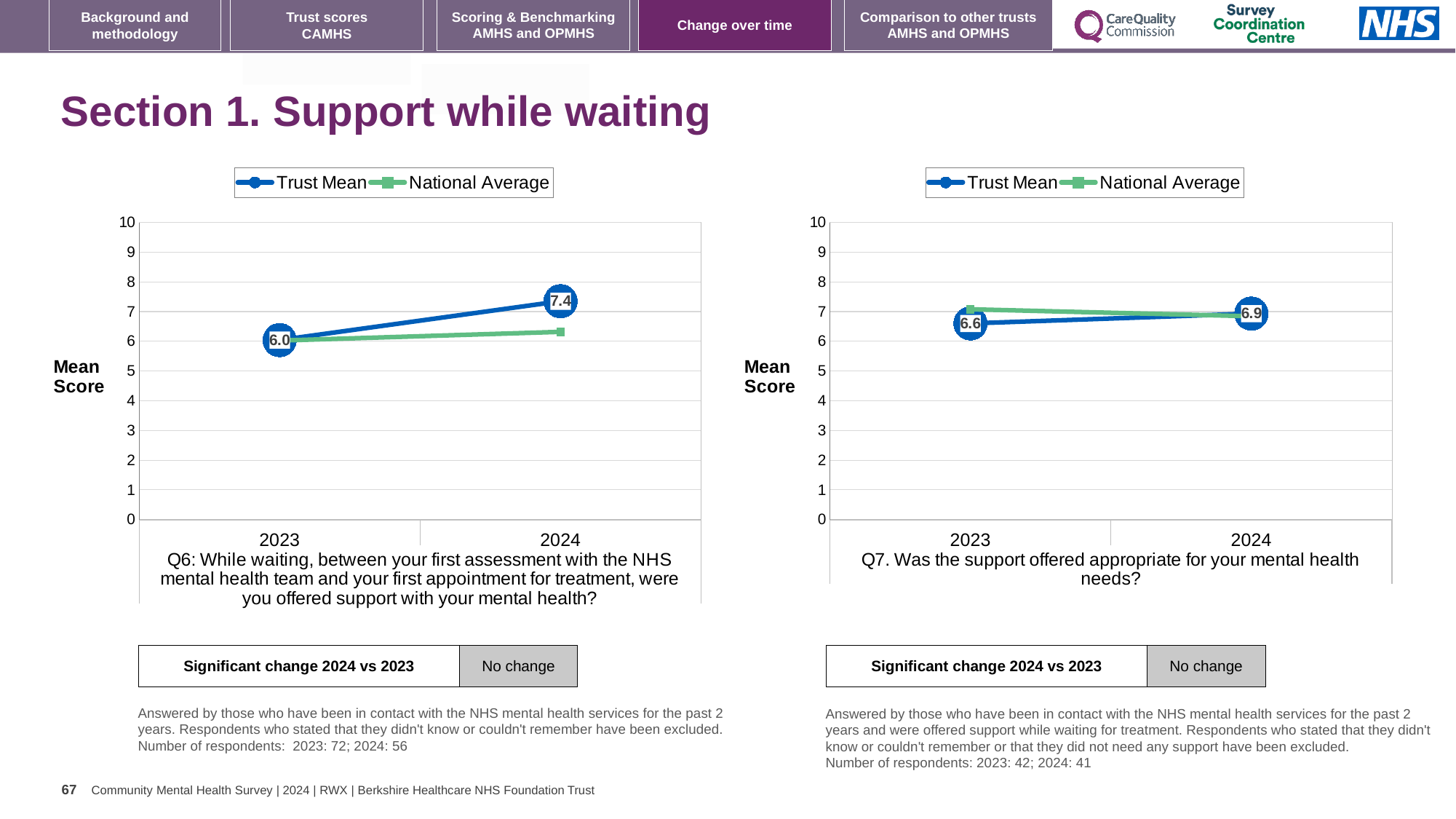
In the right chart (Q7), what is the Trust Mean score for 2023? 6.6 In the right chart (Q7), what is the Trust Mean score for 2024? 6.9 In the left chart (Q6), what is the Trust Mean score for 2023? 6.0 What type of chart is used for Q7 on the right? line chart In the left chart (Q6), is the Trust Mean higher in 2023 or in 2024? 2024 How many series does the legend of the left chart list? 2 In the left chart (Q6), by how much did the Trust Mean change from 2023 to 2024? 1.4 In the right chart (Q7), what is the difference between the Trust Mean in 2024 and in 2023? 0.3 How many years are plotted on the x axis of the right chart (Q7)? 2 In the left chart (Q6), does the Trust Mean rise or fall from 2023 to 2024? rise In the left chart (Q6), is the National Average value for 2024 greater or less than 7? less In the left chart (Q6), what is the Trust Mean score for 2024? 7.4